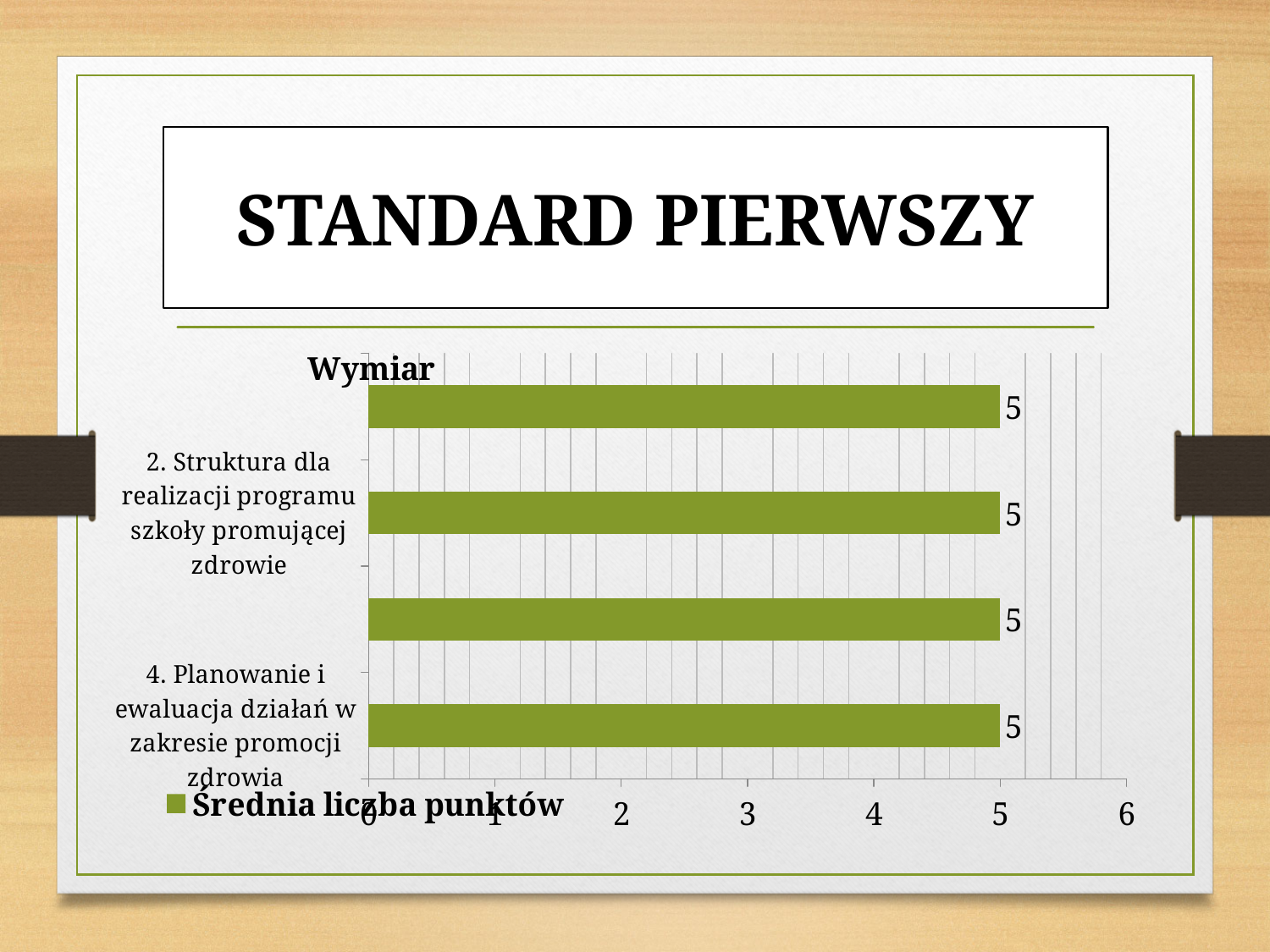
Is the value for "4. Planowanie i ewaluacja działań w zakresie promocji zdrowia" greater or less than 4? greater What is the value for "2. Struktura dla realizacji programu szkoły promującej zdrowie"? 5 What kind of chart is shown on the slide? bar chart What series name is shown in the chart legend? Średnia liczba punktów What is the highest value shown on the x axis? 6 What is the difference between the values for "2. Struktura dla realizacji programu szkoły promującej zdrowie" and "4. Planowanie i ewaluacja działań w zakresie promocji zdrowia"? 0 How many bars are plotted in the chart? 4 What is the value for "4. Planowanie i ewaluacja działań w zakresie promocji zdrowia"? 5 What is the title of the chart? Wymiar How many series does the legend list? 1 Is the value for "2. Struktura dla realizacji programu szkoły promującej zdrowie" greater or less than 6? less